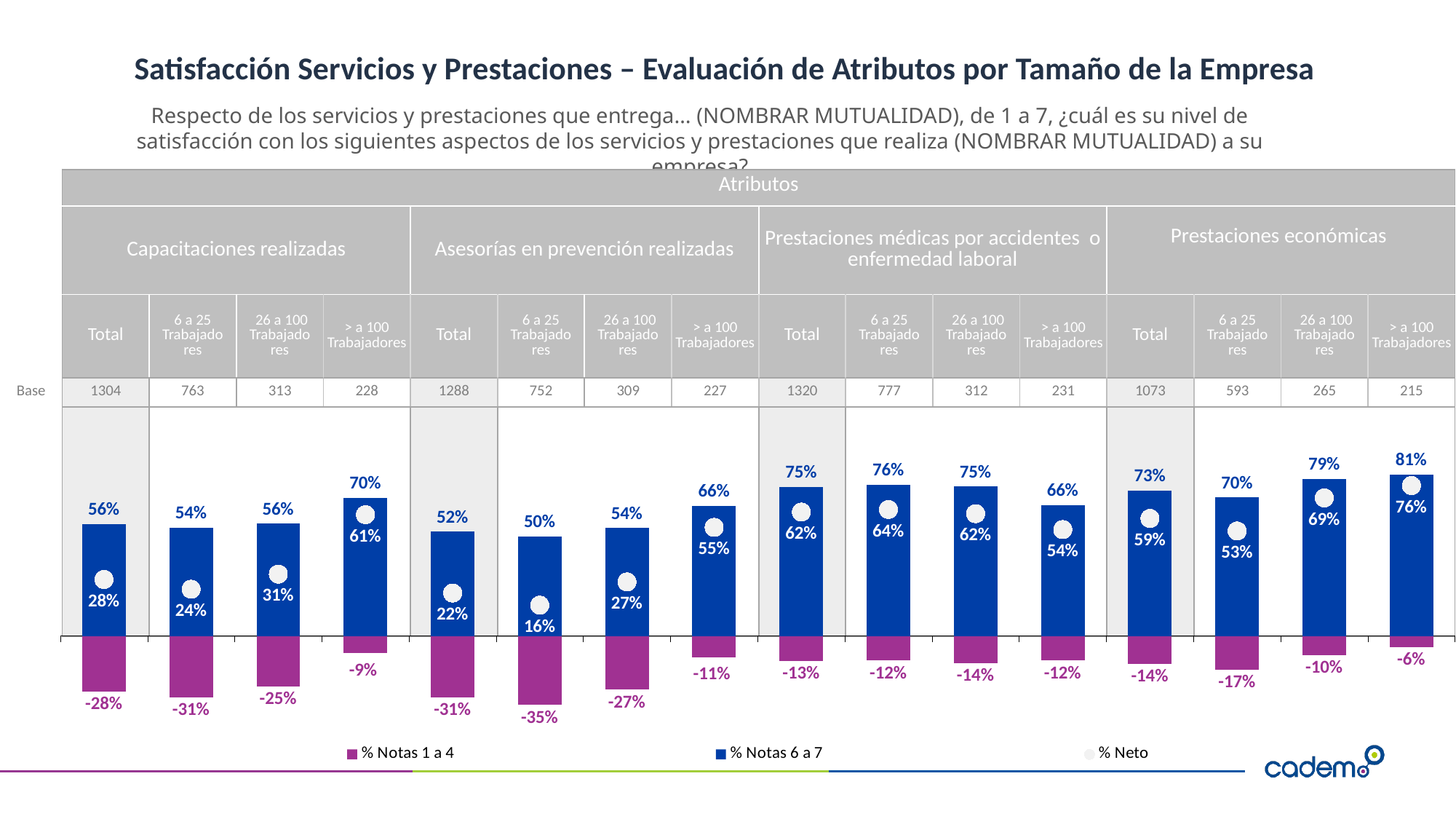
What is the Base for the Total column under Prestaciones médicas por accidentes o enfermedad laboral? 1320 What colour are the bars for the % Notas 1 a 4 series? Purple What is the % Notas 6 a 7 value for the Total column under Capacitaciones realizadas? 56% What is the % Notas 1 a 4 value for 6 a 25 Trabajadores under Asesorías en prevención realizadas? -35% Which category has the lowest % Notas 6 a 7 value? 6 a 25 Trabajadores, Asesorías en prevención realizadas What kind of chart is shown on the slide? Bar chart Which category has the most negative % Notas 1 a 4 value? 6 a 25 Trabajadores, Asesorías en prevención realizadas (-35%) Which is larger: the % Neto for 26 a 100 Trabajadores under Prestaciones económicas or the % Neto for 26 a 100 Trabajadores under Prestaciones médicas por accidentes o enfermedad laboral? Prestaciones económicas (69%) Which category has the highest % Notas 6 a 7 value? > a 100 Trabajadores, Prestaciones económicas How many series does the legend list? 3 What is the % Neto value for > a 100 Trabajadores under Prestaciones económicas? 76% What is the difference between the % Notas 6 a 7 values for > a 100 Trabajadores and Total under Capacitaciones realizadas? 14%